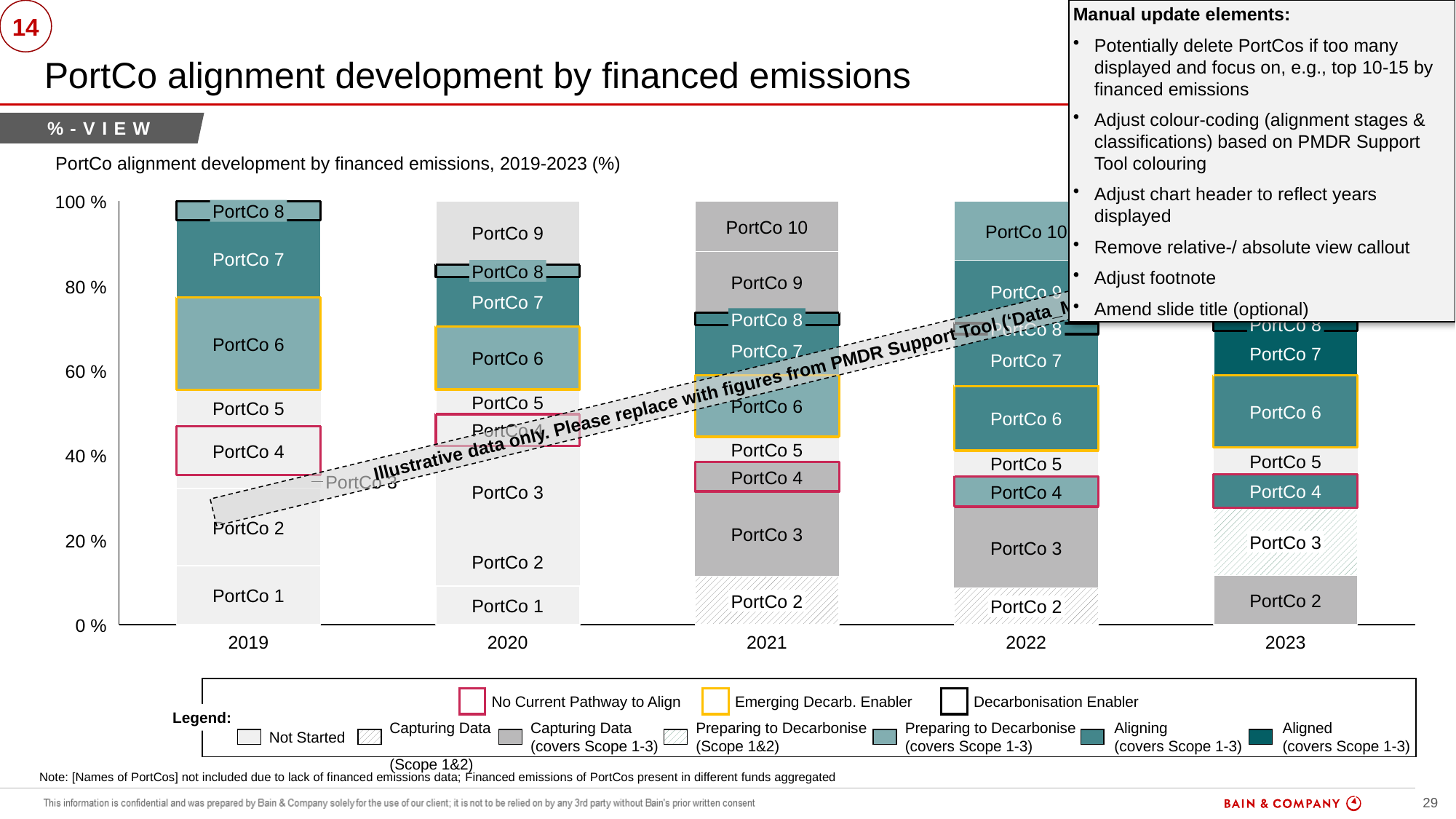
Which PortCo is the bottom segment of the 2021 bar? PortCo 2 Which PortCo is the top segment of the 2021 bar? PortCo 10 Which PortCo is the bottom segment of the 2019 bar? PortCo 1 What is the chart's subtitle above the plot area? PortCo alignment development by financed emissions, 2019-2023 (%) Is the top of the PortCo 1 segment in the 2019 bar greater or less than 20 %? less Which years are shown on the x axis of the chart? 2019, 2020, 2021, 2022, 2023 What type of chart is shown on the slide? Stacked bar chart What is the highest value shown on the y axis? 100 % Which PortCo is the bottom segment of the 2023 bar? PortCo 2 How many PortCo segments make up the 2021 bar? 9 Does the 2021 bar include a PortCo 1 segment? No How many years are shown along the x axis of the chart? 5